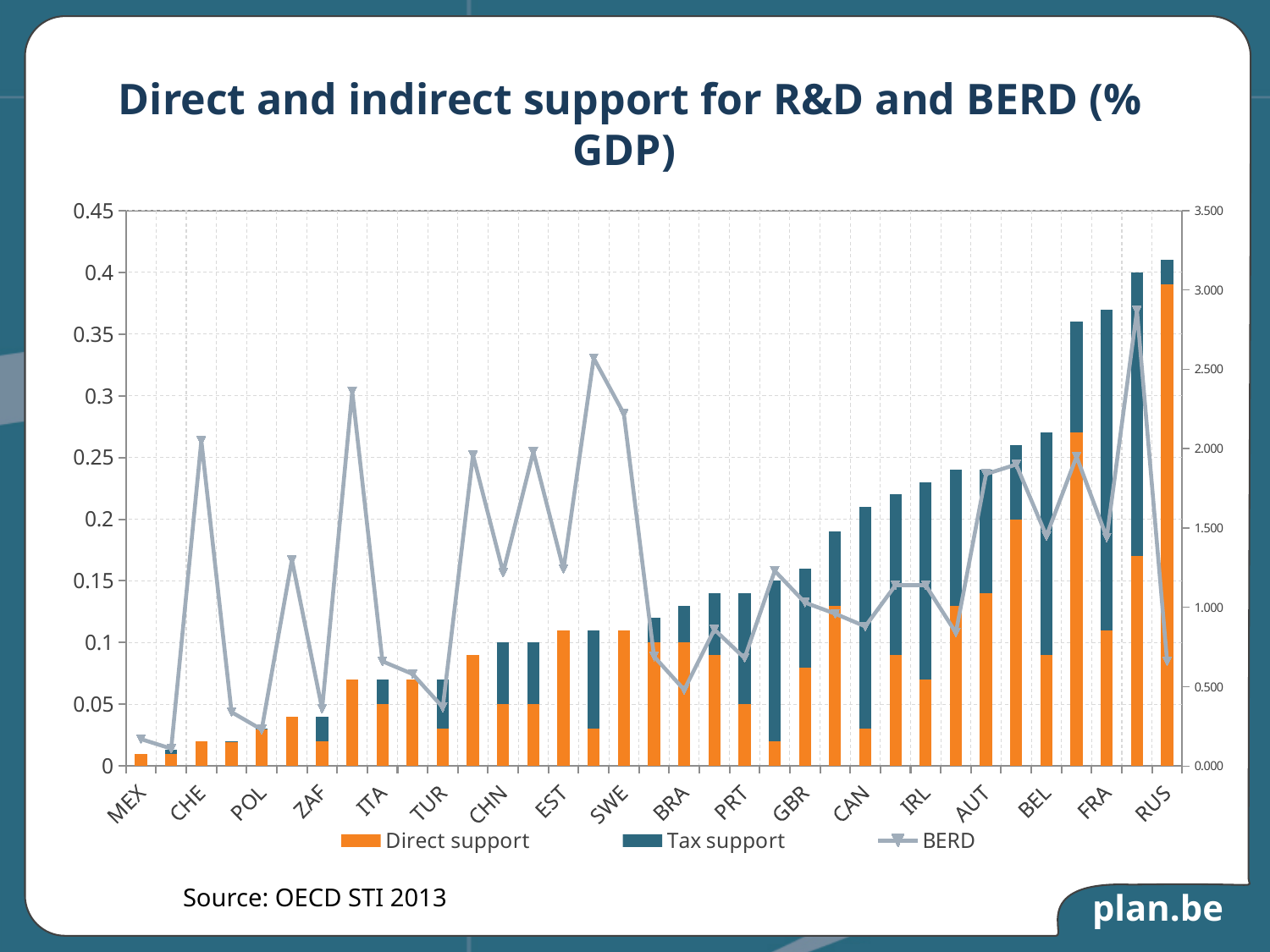
What kind of chart is shown on the slide? A bar chart with a line series Is the total stacked bar for MEX greater or less than 0.05? less Which country has the lowest total stacked bar (direct plus tax support)? MEX How many series does the legend list? 3 Is the total stacked bar for FRA greater or less than 0.3? greater What are the three series named in the legend? Direct support, Tax support, BERD Do the total stacked bars generally rise or fall from left (MEX) to right (RUS)? rise Is the total stacked bar for RUS greater or less than 0.35? greater Which has a larger total stacked bar, RUS or MEX? RUS What is the title of the chart? Direct and indirect support for R&D and BERD (% GDP) Which country has the highest total stacked bar (direct plus tax support)? RUS